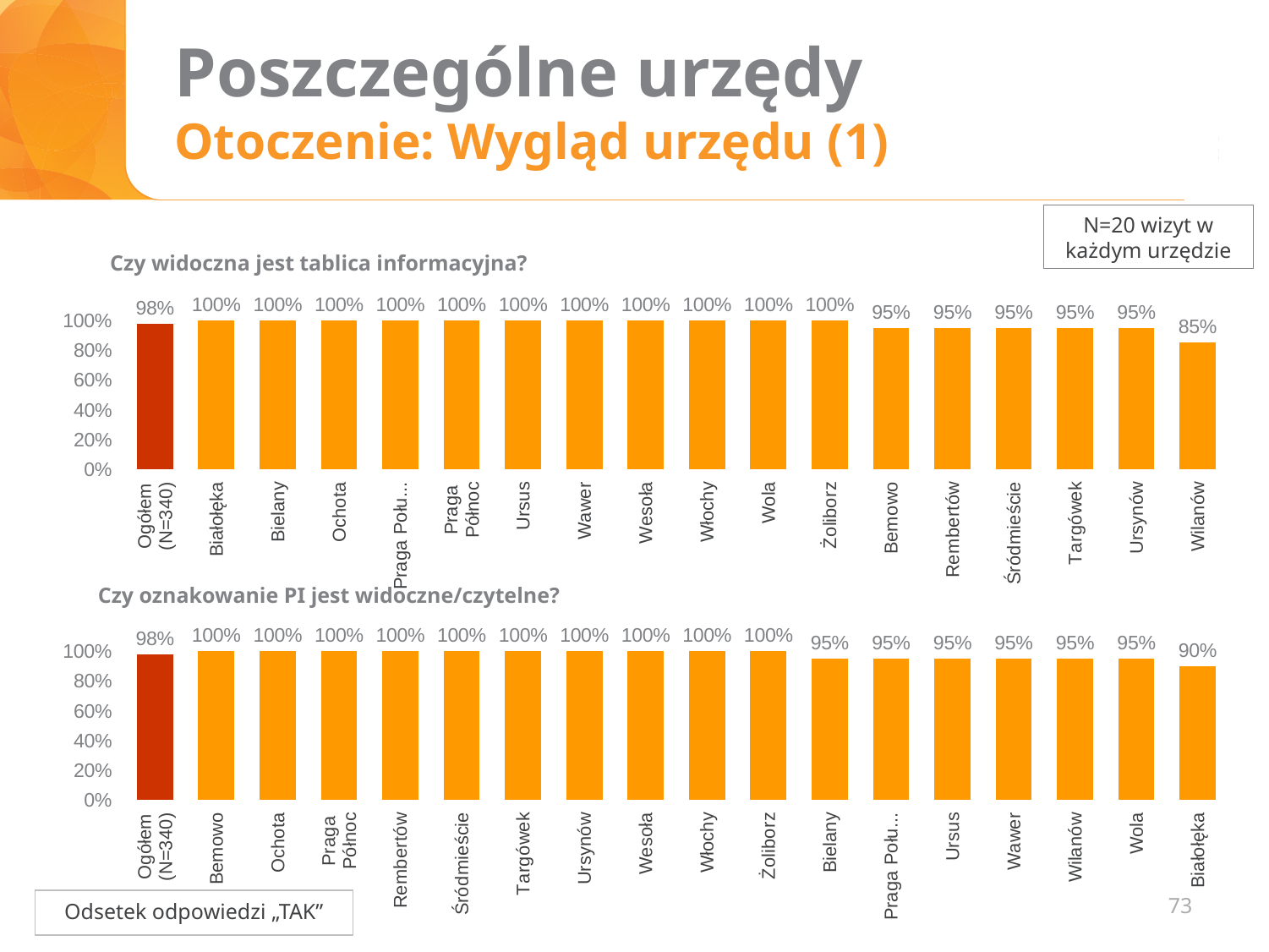
In the chart 'Czy widoczna jest tablica informacyjna?', what is the difference between the values for Białołęka and Bemowo? 5% What type of chart is 'Czy oznakowanie PI jest widoczne/czytelne?'? Bar chart How many bars are shown in the chart 'Czy widoczna jest tablica informacyjna?'? 18 In the chart 'Czy widoczna jest tablica informacyjna?', which category has the lowest value? Wilanów In the chart 'Czy oznakowanie PI jest widoczne/czytelne?', what is the difference between the values for Ogółem (N=340) and Białołęka? 8% In the chart 'Czy oznakowanie PI jest widoczne/czytelne?', which category has the lowest value? Białołęka In the chart 'Czy widoczna jest tablica informacyjna?', what is the value for Ogółem (N=340)? 98% In the chart 'Czy oznakowanie PI jest widoczne/czytelne?', what is the value for Białołęka? 90% In the chart 'Czy widoczna jest tablica informacyjna?', which bar is shown in a different (darker red) colour from the others? Ogółem (N=340) In the chart 'Czy widoczna jest tablica informacyjna?', what is the value for Wilanów? 85% In the chart 'Czy oznakowanie PI jest widoczne/czytelne?', which is larger, the value for Bemowo or the value for Bielany? Bemowo In the chart 'Czy oznakowanie PI jest widoczne/czytelne?', what is the value for Wola? 95%